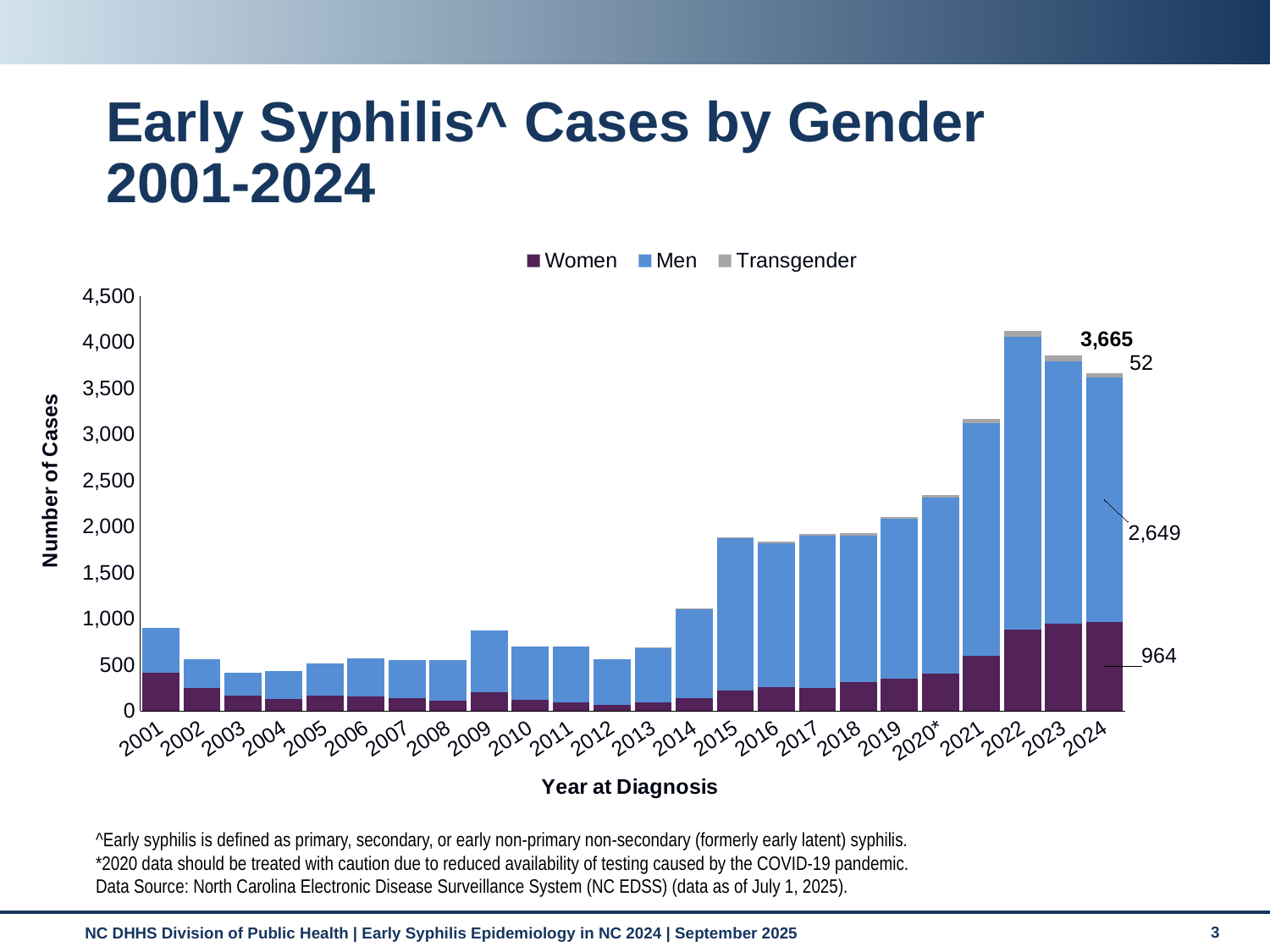
What kind of chart is shown on the slide? Stacked bar chart Which year has the highest total number of early syphilis cases? 2022 Is the total number of cases in 2022 greater or less than 4,000? greater Which year had more total cases, 2022 or 2023? 2022 What is the label of the x axis? Year at Diagnosis What is the total number of early syphilis cases in 2024? 3,665 How many early syphilis cases among transgender people were reported in 2024? 52 How many years are shown along the x axis? 24 How many series does the legend list? 3 How many early syphilis cases among men were reported in 2024? 2,649 In 2024, how many more cases were among men than among women? 1,685 How many early syphilis cases among women were reported in 2024? 964